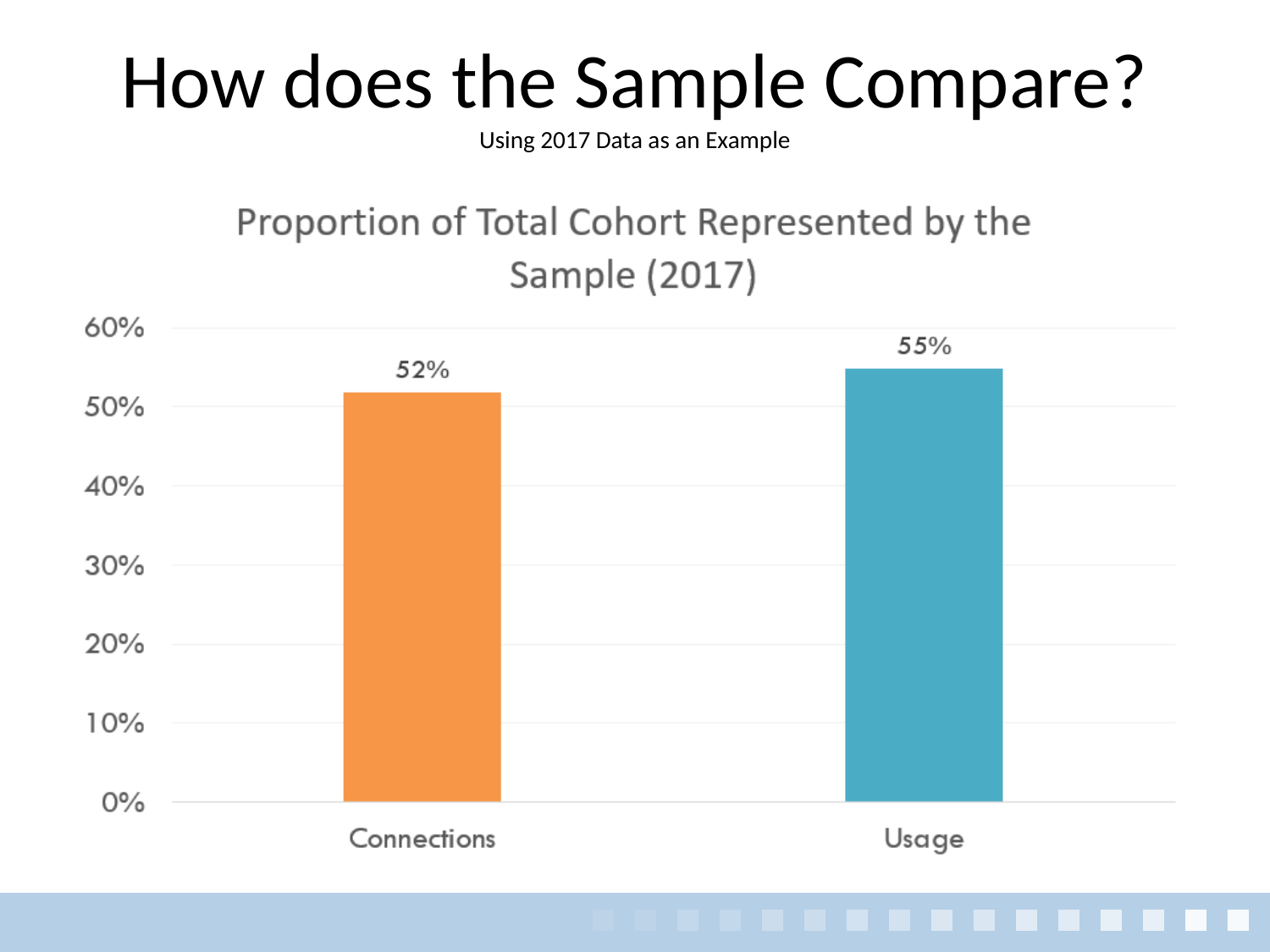
How many categories are shown on the x axis? 2 Which category has the highest value? Usage What is the value for Connections? 52% What kind of chart is shown on the slide? Bar chart Which is larger, the value for Connections or the value for Usage? Usage Is the value for Connections greater or less than 50%? greater Is the value for Usage greater or less than 60%? less What is the value for Usage? 55% What is the difference between the values for Usage and Connections? 3% Which category has the lowest value? Connections What is the title of the chart? Proportion of Total Cohort Represented by the Sample (2017) What colour is the bar for Usage? Blue